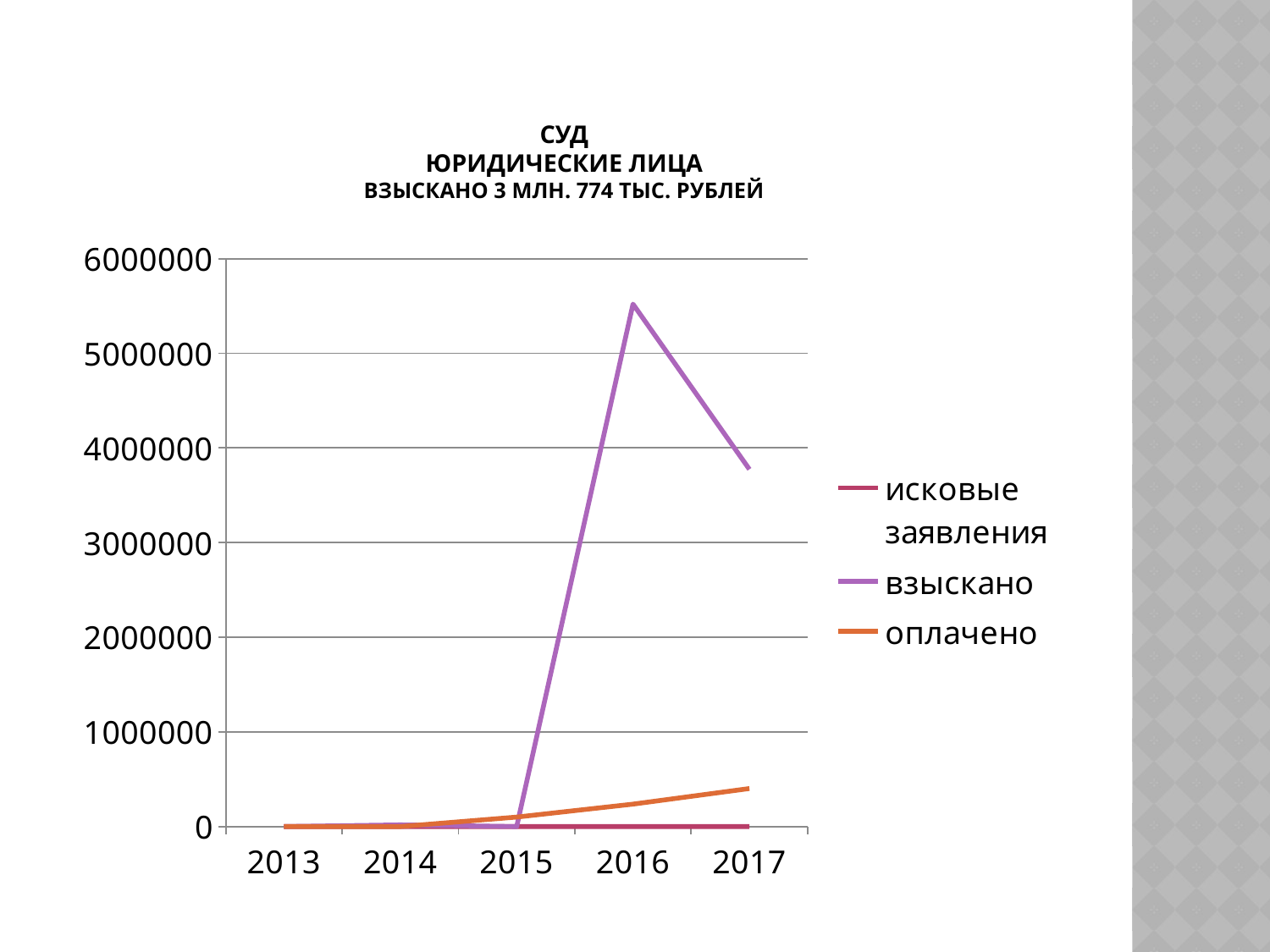
Is the value of 'взыскано' in 2016 greater or less than 5000000? greater Does the 'оплачено' series rise or fall from 2015 to 2017? rise In which year does the 'взыскано' series reach its highest value? 2016 Does the 'взыскано' series rise or fall from 2016 to 2017? fall What amount is stated in the chart title as collected (взыскано)? 3 млн. 774 тыс. рублей What kind of chart is shown on the slide? line chart Is the value of 'взыскано' in 2017 greater or less than 4000000? less How many series does the chart legend list? 3 Which series has the larger value in 2016, 'взыскано' or 'оплачено'? взыскано Is the value of 'оплачено' in 2017 greater or less than 1000000? less How many years are shown on the x axis of the chart? 5 Which series is drawn in orange in the chart? оплачено